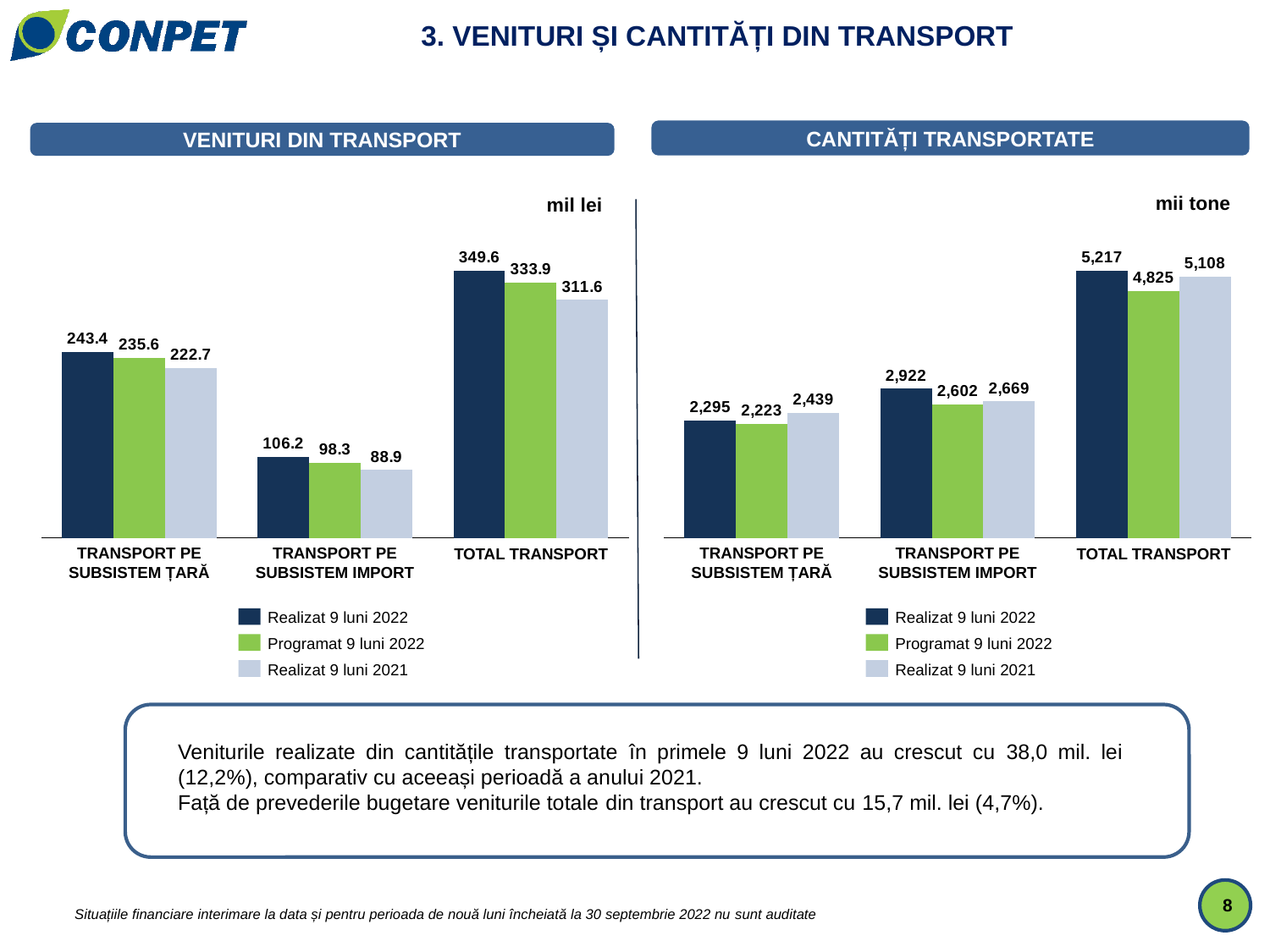
In the CANTITĂȚI TRANSPORTATE chart, which is larger for TRANSPORT PE SUBSISTEM ȚARĂ: Realizat 9 luni 2022 or Realizat 9 luni 2021? Realizat 9 luni 2021 In the CANTITĂȚI TRANSPORTATE chart, what is the value for Realizat 9 luni 2021 for TOTAL TRANSPORT? 5,108 In the CANTITĂȚI TRANSPORTATE chart, what is the difference between Realizat 9 luni 2022 and Programat 9 luni 2022 for TOTAL TRANSPORT? 392 In the VENITURI DIN TRANSPORT chart, what is the value for Realizat 9 luni 2022 for TOTAL TRANSPORT? 349.6 In the CANTITĂȚI TRANSPORTATE chart, what is the value for Programat 9 luni 2022 for TRANSPORT PE SUBSISTEM ȚARĂ? 2,223 What kind of chart is the VENITURI DIN TRANSPORT chart? Bar chart How many series does the legend of the VENITURI DIN TRANSPORT chart list? 3 In the VENITURI DIN TRANSPORT chart, which series has the lowest value for TRANSPORT PE SUBSISTEM ȚARĂ? Realizat 9 luni 2021 In the CANTITĂȚI TRANSPORTATE chart, which series has the highest value for TRANSPORT PE SUBSISTEM IMPORT? Realizat 9 luni 2022 In the VENITURI DIN TRANSPORT chart, what is the value for Realizat 9 luni 2021 for TRANSPORT PE SUBSISTEM IMPORT? 88.9 How many categories are shown on the x axis of the CANTITĂȚI TRANSPORTATE chart? 3 In the VENITURI DIN TRANSPORT chart, what is the difference between Realizat 9 luni 2022 and Realizat 9 luni 2021 for TOTAL TRANSPORT? 38.0